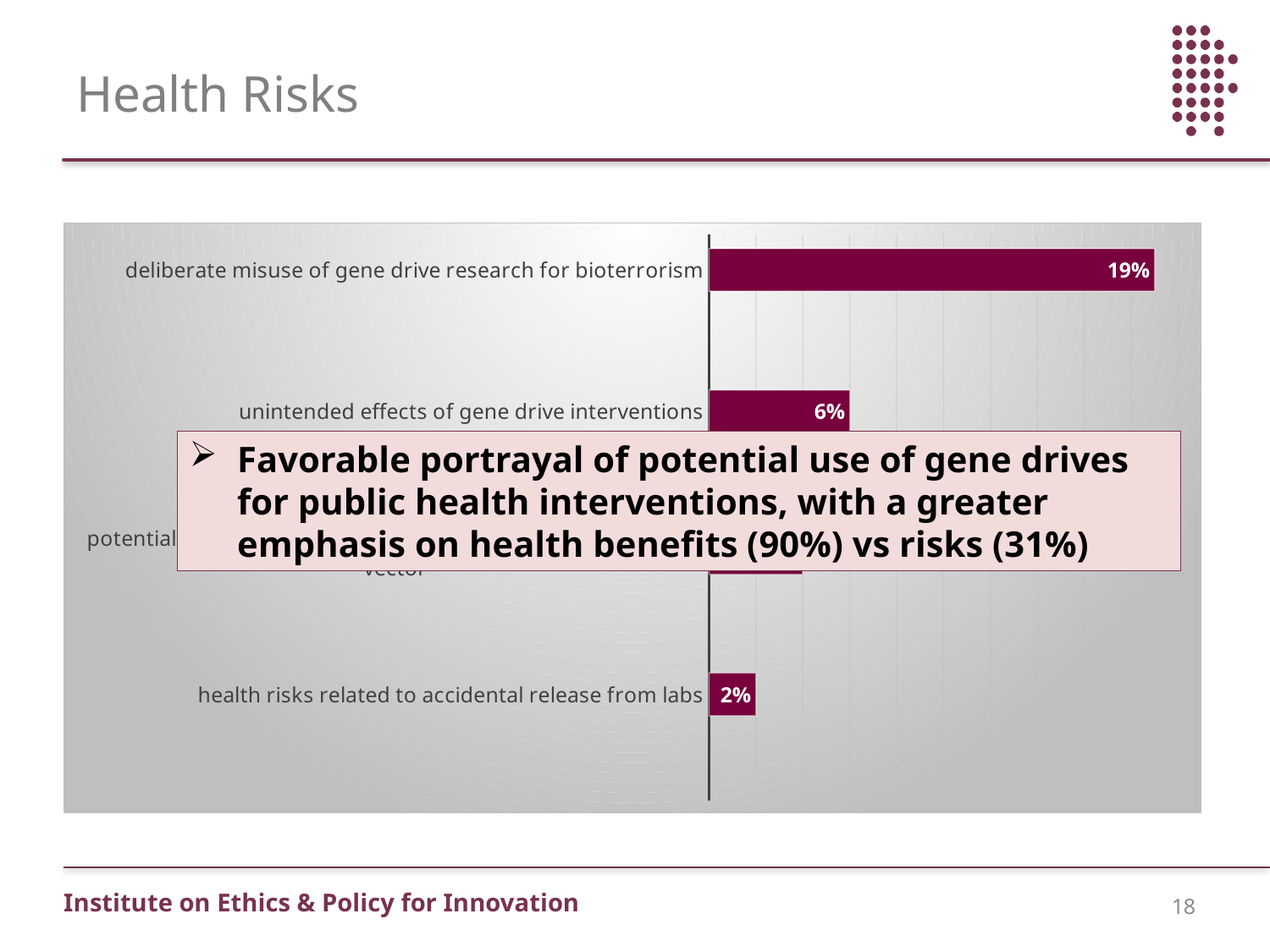
Which is larger: the value for 'deliberate misuse of gene drive research for bioterrorism' or for 'unintended effects of gene drive interventions'? deliberate misuse of gene drive research for bioterrorism Which category has the lowest value? health risks related to accidental release from labs What kind of chart is shown on the slide? bar chart What is the difference between the values for 'deliberate misuse of gene drive research for bioterrorism' and 'unintended effects of gene drive interventions'? 13 percentage points What is the difference between the values for 'unintended effects of gene drive interventions' and 'health risks related to accidental release from labs'? 4 percentage points What is the title of the slide containing the chart? Health Risks Which category has the highest value? deliberate misuse of gene drive research for bioterrorism What is the value for 'unintended effects of gene drive interventions'? 6% How many bars are plotted in the chart? 4 What is the value for 'deliberate misuse of gene drive research for bioterrorism'? 19% What is the value for 'health risks related to accidental release from labs'? 2% Which is larger: the value for 'unintended effects of gene drive interventions' or for 'health risks related to accidental release from labs'? unintended effects of gene drive interventions